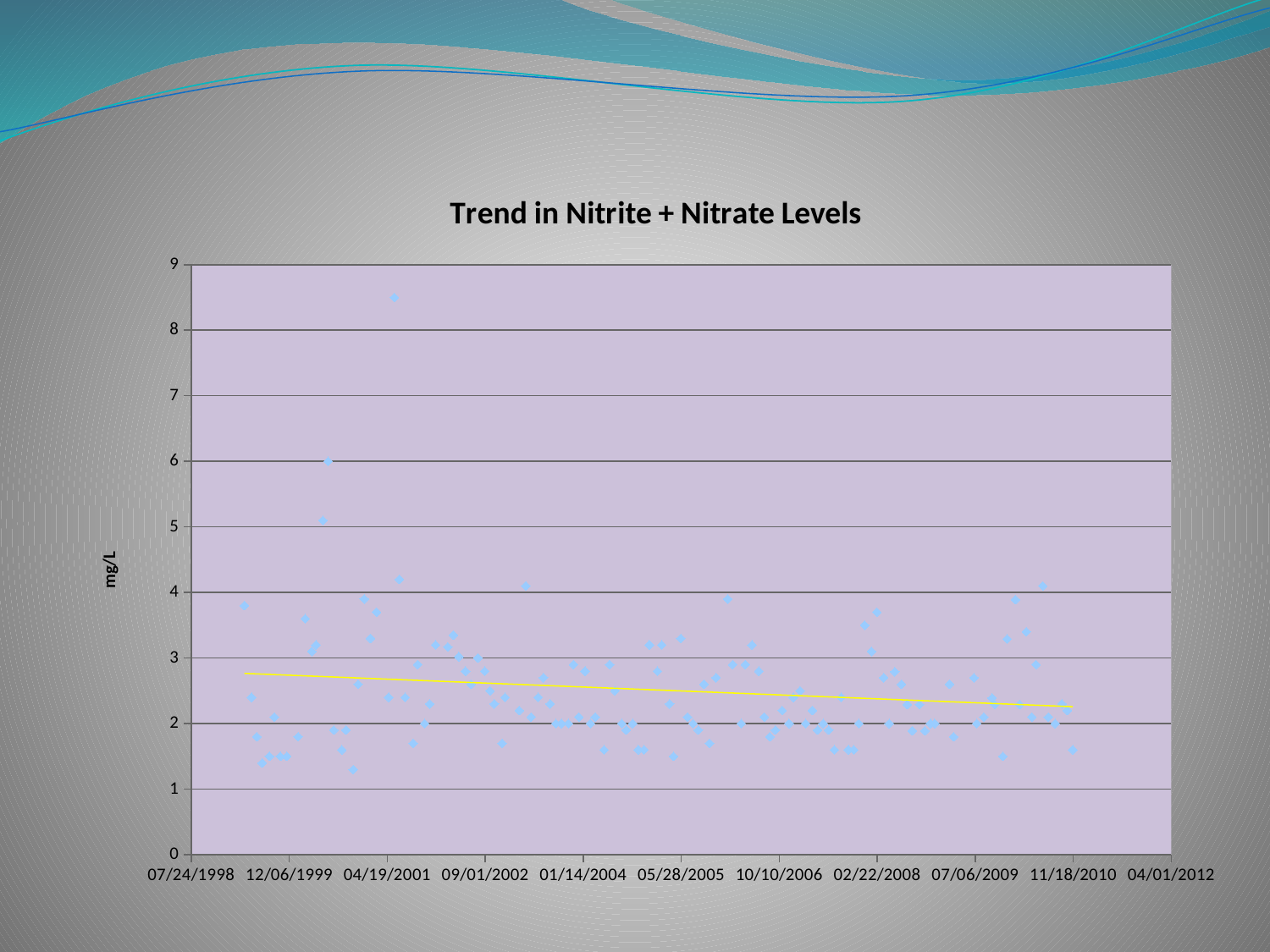
What is the first date label shown on the horizontal axis? 07/24/1998 Is the highest plotted point on the chart greater or less than 8 mg/L? greater What kind of chart is shown on the slide? scatter chart What is the label on the vertical axis of the chart? mg/L What is the last date label shown on the horizontal axis? 04/01/2012 Is the value of the yellow trend line at its left end greater or less than 3 mg/L? less Is the lowest plotted point on the chart greater or less than 1 mg/L? greater Is the value of the yellow trend line at its left end greater or less than its value at its right end? greater What is the title of the chart? Trend in Nitrite + Nitrate Levels Does the yellow trend line rise or fall from left to right across the chart? fall What is the maximum value shown on the vertical axis? 9